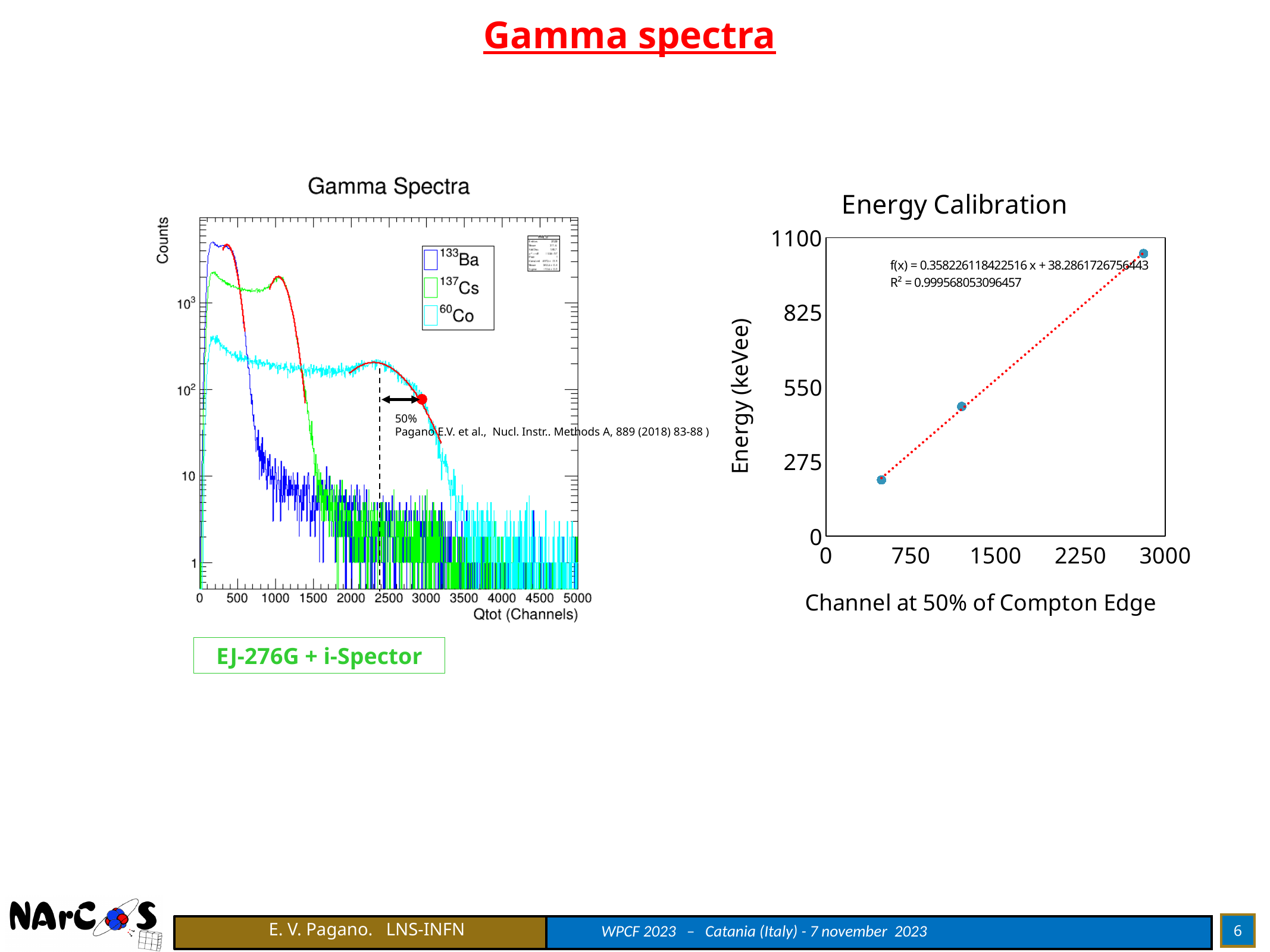
In the Gamma Spectra chart, which series has its Compton edge at the lowest channel? 133Ba In the Energy Calibration chart, is the energy of the highest point greater or less than 825 keVee? greater In the Energy Calibration chart, do the energy values rise or fall as the channel increases? rise In the Energy Calibration chart, is the channel of the lowest point greater or less than 750? less How many series does the legend of the Gamma Spectra chart list? 3 How many data points are plotted in the Energy Calibration chart? 3 What R² value is printed on the Energy Calibration chart? 0.999568053096457 What is the x-axis label of the Energy Calibration chart? Channel at 50% of Compton Edge In the Energy Calibration chart, is the channel of the highest point greater or less than 2250? greater What kind of chart is the Energy Calibration chart? scatter chart with a linear trendline In the Gamma Spectra chart, which series has its Compton edge at the highest channel? 60Co